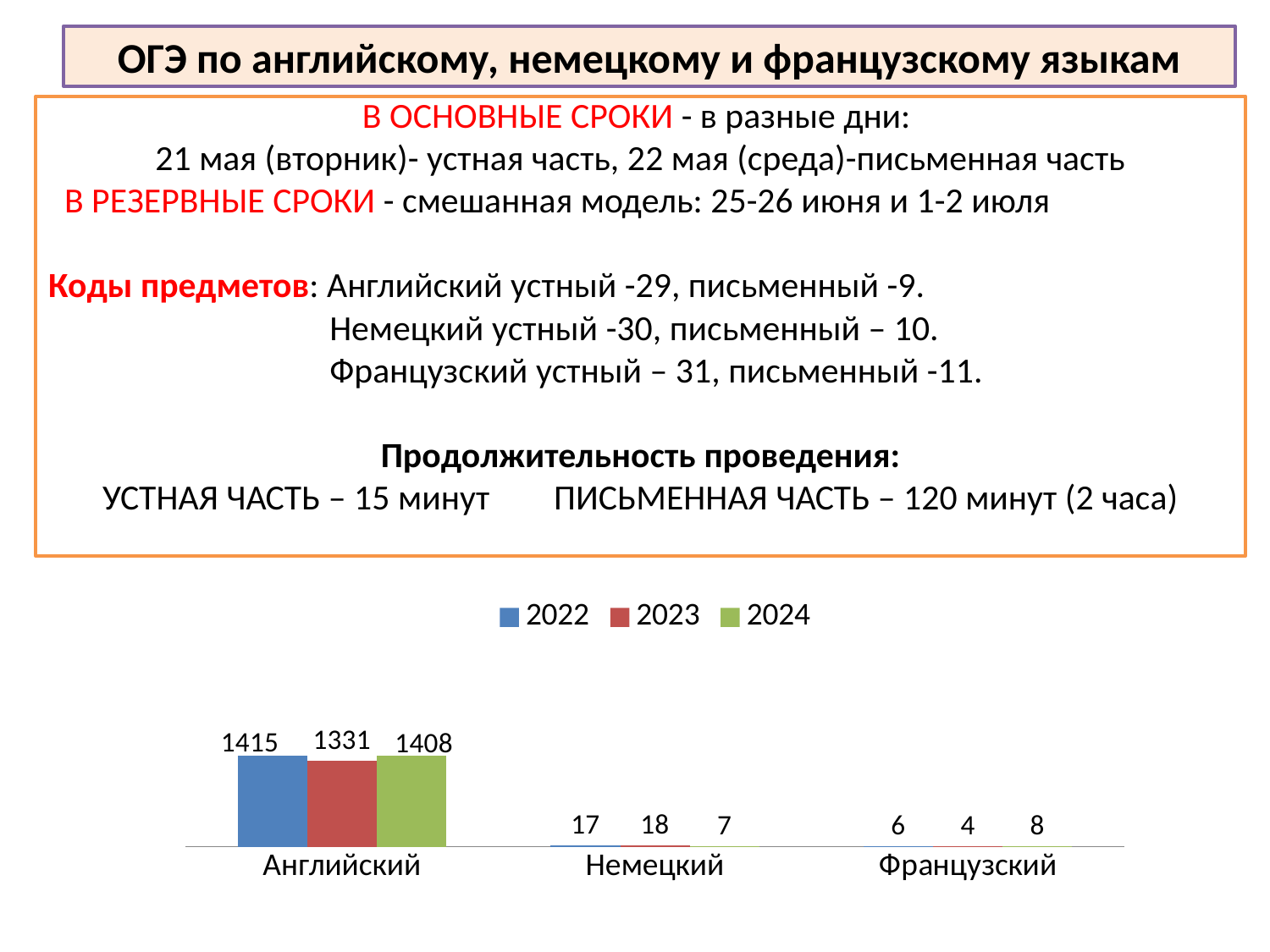
What is the difference between the 2022 and 2023 values for Английский? 84 Which is larger for Немецкий: the 2022 value or the 2024 value? 2022 What is the value for Английский in 2022? 1415 What is the value for Немецкий in 2023? 18 Do the values for Немецкий rise or fall from 2023 to 2024? fall How many series does the legend list? 3 What is the value for Французский in 2024? 8 What kind of chart is shown on the slide? bar chart How many categories are shown on the x axis? 3 Which category has the lowest value in 2023? Французский Which category has the highest value in 2024? Английский Which colour represents the 2023 series in the legend? red